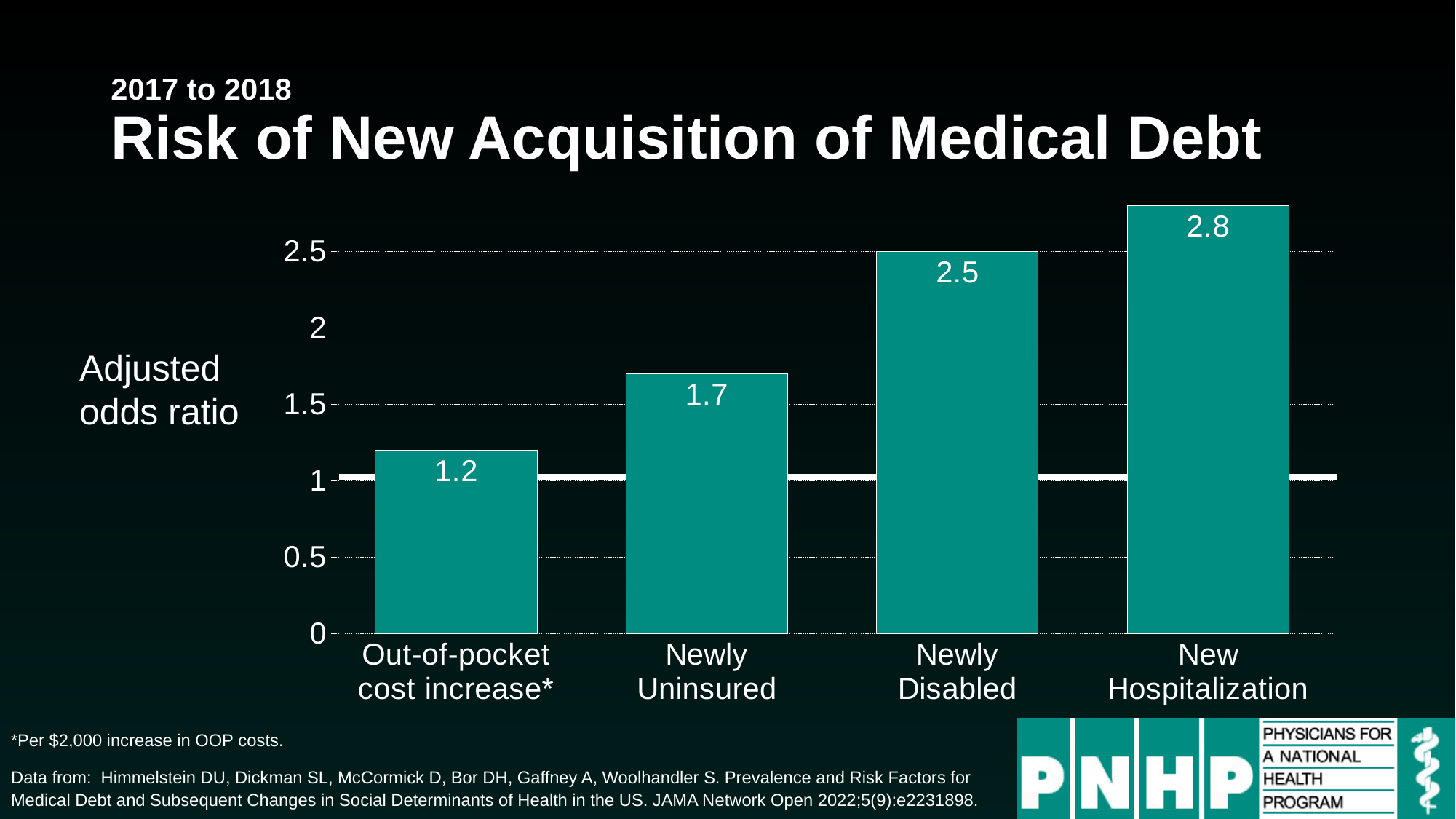
Which category has the lowest adjusted odds ratio? Out-of-pocket cost increase What is the adjusted odds ratio for Out-of-pocket cost increase? 1.2 What is the adjusted odds ratio for Newly Uninsured? 1.7 Do the adjusted odds ratios rise or fall from left to right across the categories? Rise Is the adjusted odds ratio for Newly Disabled greater or less than 2? greater What kind of chart is shown on the slide? Bar chart Which has a larger adjusted odds ratio, Newly Disabled or Newly Uninsured? Newly Disabled How many categories are shown in the chart? 4 What is the adjusted odds ratio for New Hospitalization? 2.8 What is the difference between the adjusted odds ratios for Newly Disabled and Newly Uninsured? 0.8 Which category has the highest adjusted odds ratio? New Hospitalization What is the title of the chart? Risk of New Acquisition of Medical Debt